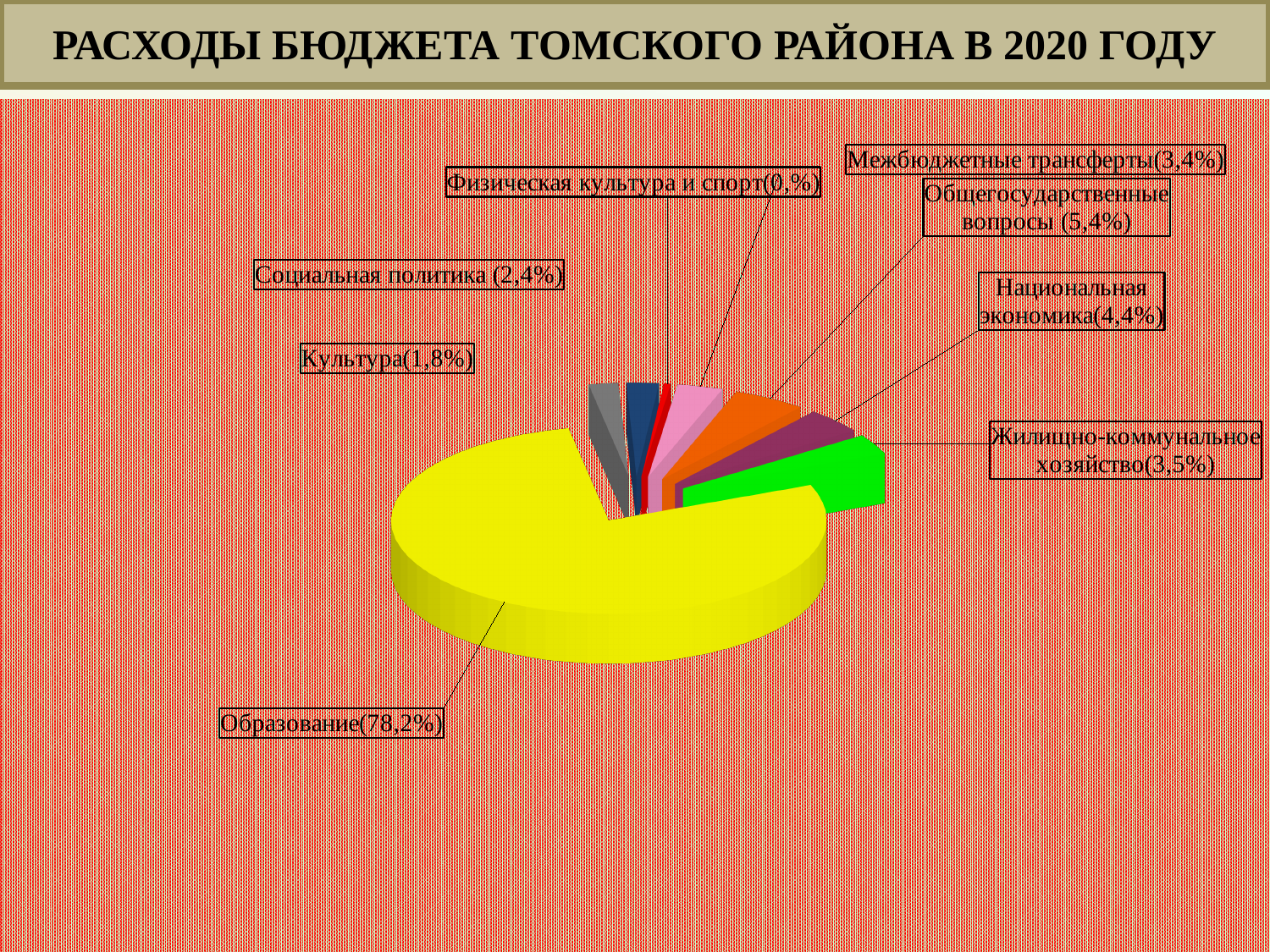
What is the value shown for Жилищно-коммунальное хозяйство? 3,5% How many categories are shown in the pie chart? 8 What is the value shown for Общегосударственные вопросы? 5,4% What is the difference in percentage points between Образование and Общегосударственные вопросы? 72,8 What is the value shown for Культура? 1,8% Which category has the largest share of the pie? Образование Which category has the smallest share of the pie? Физическая культура и спорт Which is larger: Национальная экономика or Жилищно-коммунальное хозяйство? Национальная экономика What kind of chart is shown on the slide? Pie chart What is the value shown for Социальная политика? 2,4% What share of the pie does Образование have? 78,2% What is the value shown for Национальная экономика? 4,4%